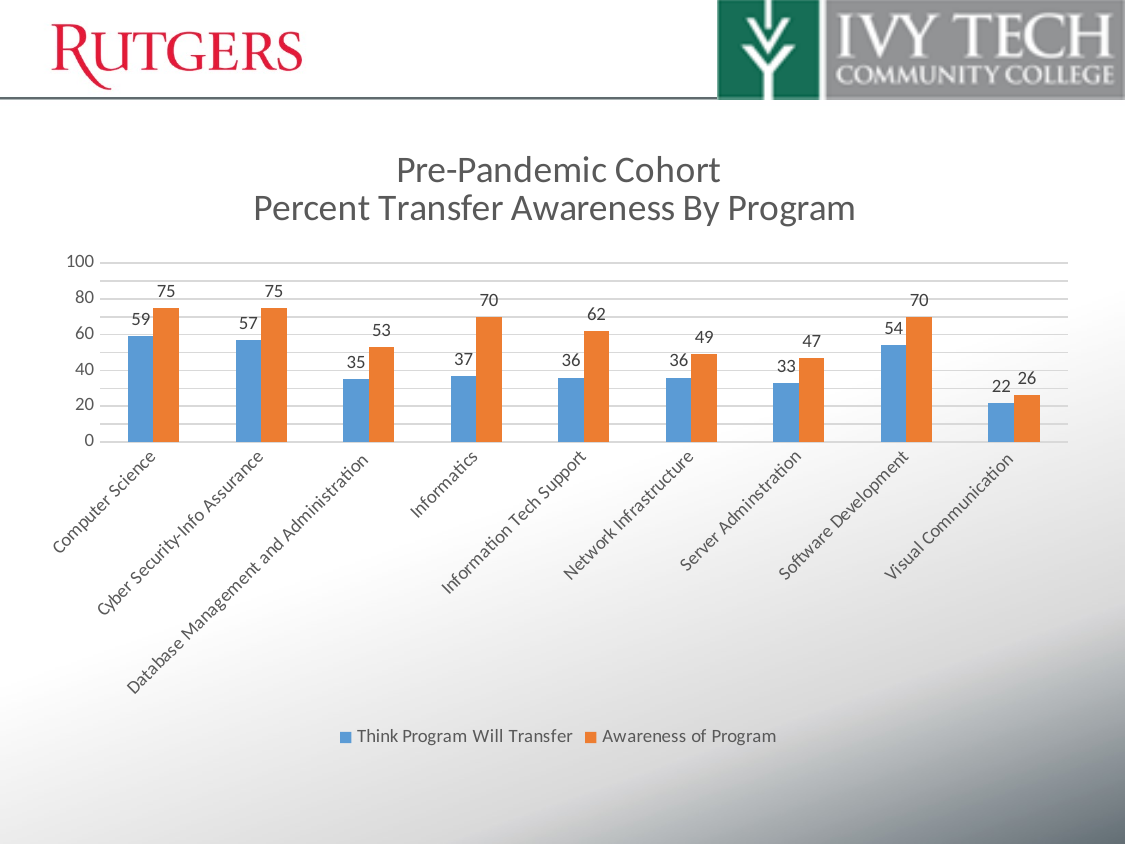
What kind of chart is shown on the slide? Bar chart What is the title of the chart? Pre-Pandemic Cohort Percent Transfer Awareness By Program Which program has the highest value for Think Program Will Transfer? Computer Science What is the value for Think Program Will Transfer for Computer Science? 59 Which program has the lowest value for Think Program Will Transfer? Visual Communication What is the value for Awareness of Program for Server Administration? 47 How many programs are shown on the x axis? 9 What is the difference between Awareness of Program and Think Program Will Transfer for Information Tech Support? 26 How many series does the legend list? 2 Which colour represents Awareness of Program in the legend? Orange What is the value for Awareness of Program for Informatics? 70 Which is larger for Software Development: Think Program Will Transfer or Awareness of Program? Awareness of Program